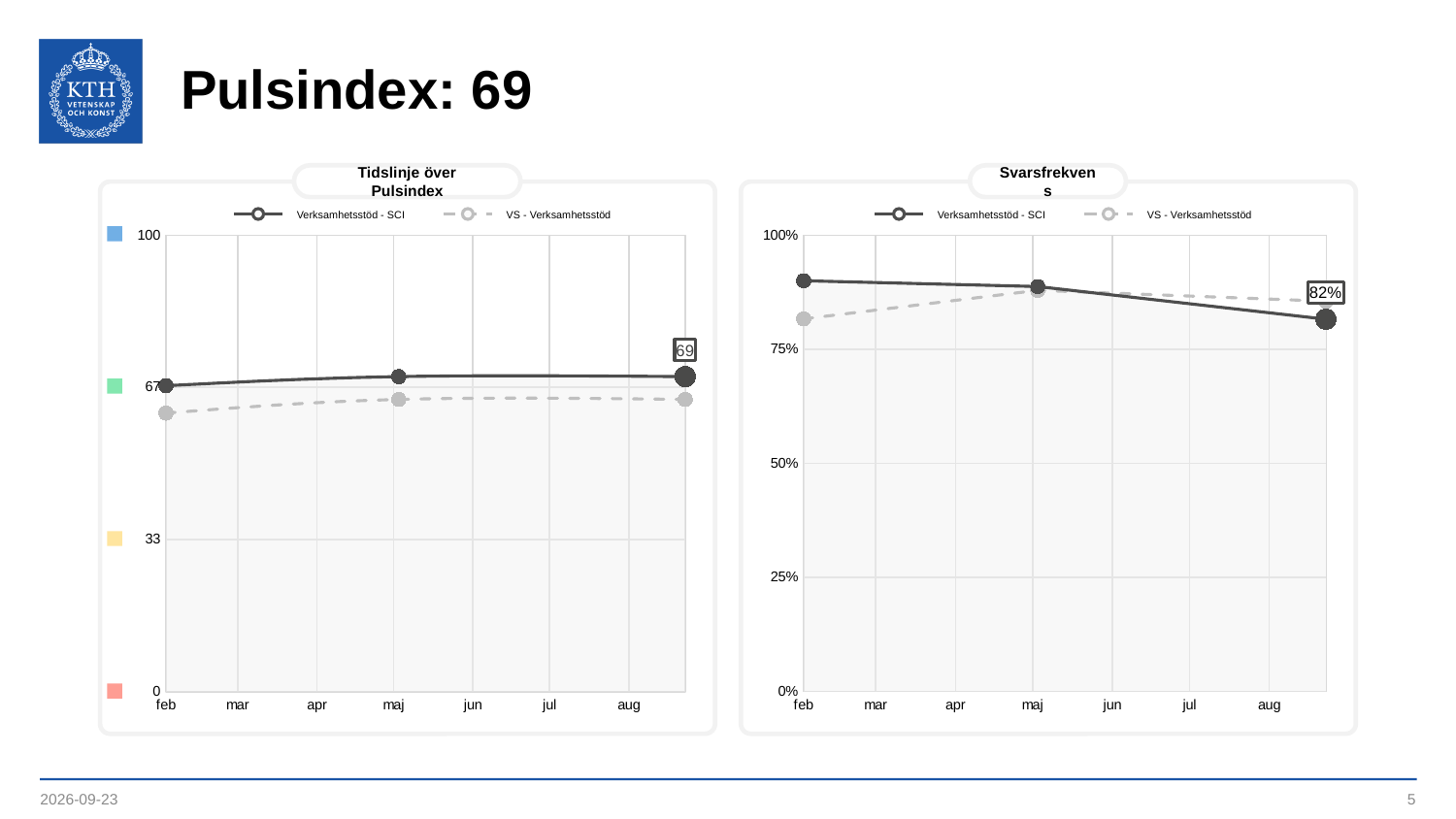
In the "Tidslinje över Pulsindex" chart, which series has the higher value in feb, Verksamhetsstöd - SCI or VS - Verksamhetsstöd? Verksamhetsstöd - SCI In the "Svarsfrekvens" chart, what is the labelled latest value of the Verksamhetsstöd - SCI series? 82% In the "Tidslinje över Pulsindex" chart, is the value for Verksamhetsstöd - SCI in feb greater or less than 33? greater How many month labels are shown on the x axis of the "Tidslinje över Pulsindex" chart? 7 How many series does the legend of the "Svarsfrekvens" chart on the right list? 2 What is the title of the chart on the right of the slide? Svarsfrekvens In the "Svarsfrekvens" chart, does the Verksamhetsstöd - SCI series rise or fall along the x axis? fall In the "Svarsfrekvens" chart, is the value for Verksamhetsstöd - SCI in feb greater or less than 75%? greater In the "Svarsfrekvens" chart, which series has the higher value in feb, Verksamhetsstöd - SCI or VS - Verksamhetsstöd? Verksamhetsstöd - SCI What kind of chart is the "Tidslinje över Pulsindex" chart on the left? line chart In the "Tidslinje över Pulsindex" chart, what is the labelled latest value of the Verksamhetsstöd - SCI series? 69